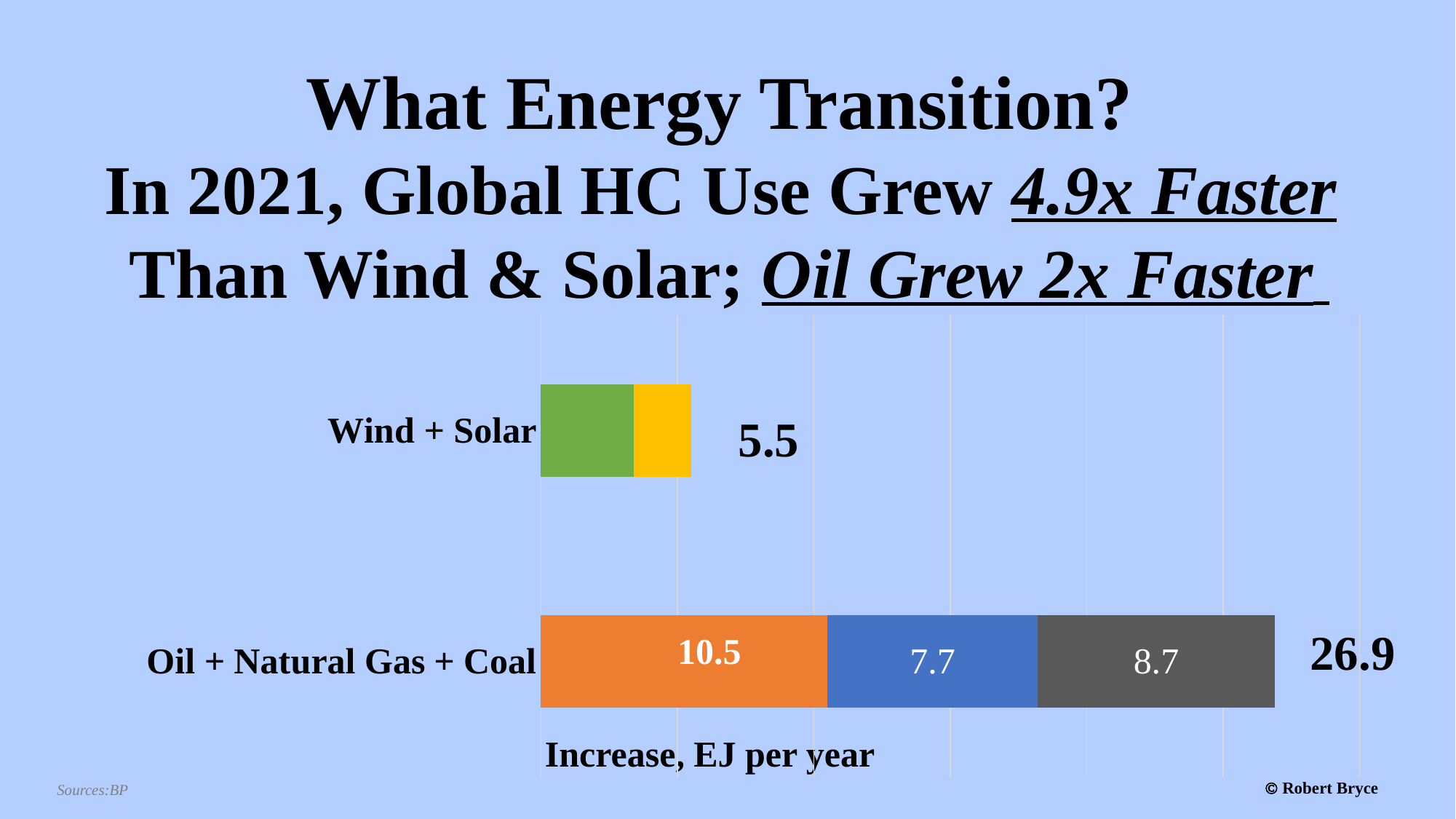
What is the value of the grey segment in the Oil + Natural Gas + Coal bar? 8.7 Which category has the highest total increase? Oil + Natural Gas + Coal What is the total value shown for the Oil + Natural Gas + Coal bar? 26.9 What kind of chart is shown on the slide? stacked bar chart What is the difference between the Oil + Natural Gas + Coal total and the Wind + Solar total? 21.4 What is the label on the value axis of the chart? Increase, EJ per year Which is larger in the Oil + Natural Gas + Coal bar: the blue segment or the grey segment? the grey segment What is the value of the orange segment in the Oil + Natural Gas + Coal bar? 10.5 Which category has the lowest total increase? Wind + Solar How many categories are plotted in the chart? 2 What is the value shown for the Wind + Solar bar? 5.5 What is the value of the blue segment in the Oil + Natural Gas + Coal bar? 7.7